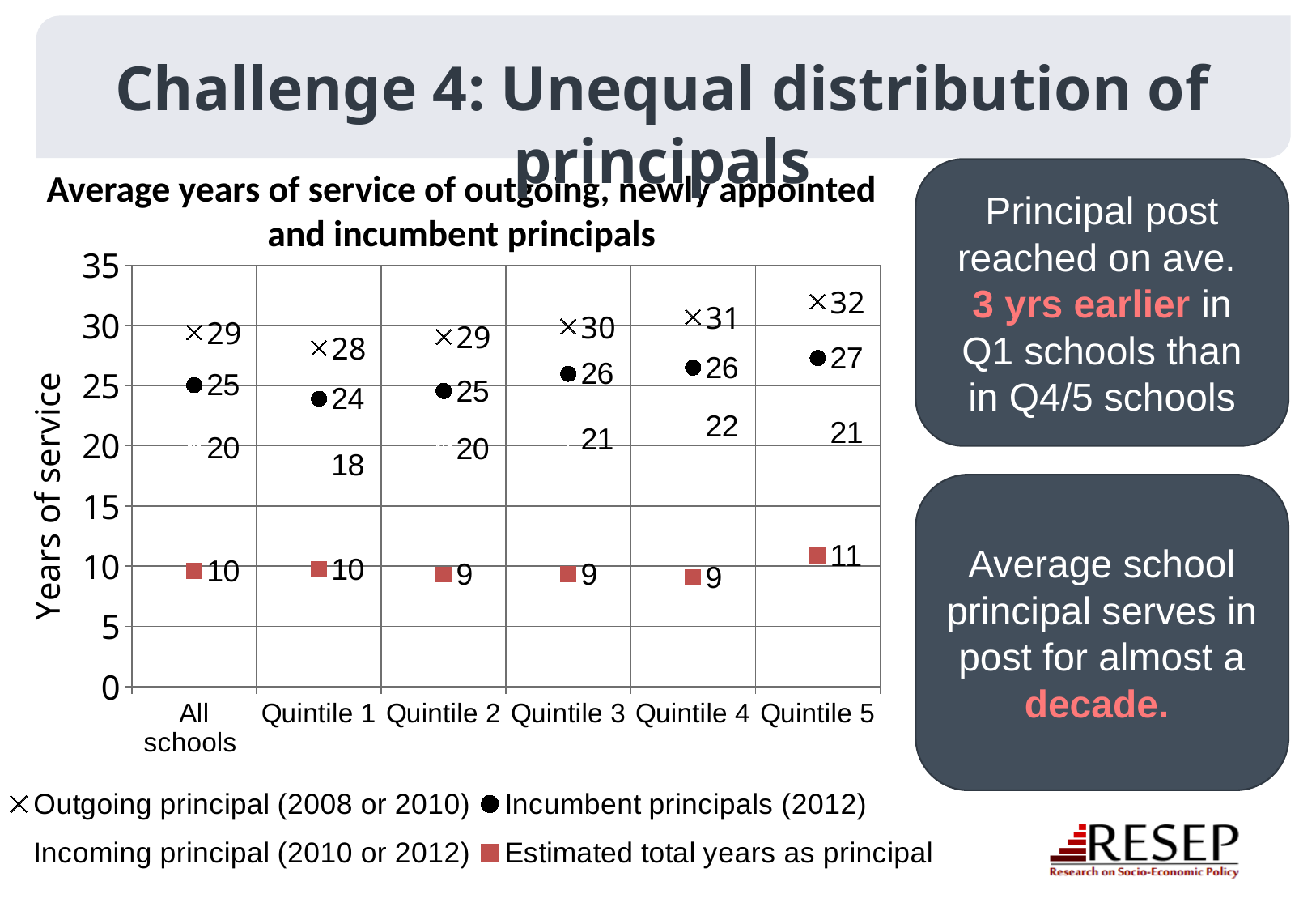
How many series does the legend list? 4 Which category has the highest value for Outgoing principal (2008 or 2010)? Quintile 5 Do the Outgoing principal (2008 or 2010) values rise or fall from Quintile 1 to Quintile 5? rise What is the value for Incoming principal (2010 or 2012) at Quintile 4? 22 What is the y-axis label of the chart? Years of service Which is larger: the Estimated total years as principal at Quintile 5 or at Quintile 4? Quintile 5 What is the value for Incumbent principals (2012) at Quintile 1? 24 What is the value for Outgoing principal (2008 or 2010) at Quintile 5? 32 What is the difference between the Outgoing principal value and the Incumbent principals value at Quintile 3? 4 How many categories are shown on the x axis? 6 What is the Estimated total years as principal for All schools? 10 Which category has the lowest value for Incoming principal (2010 or 2012)? Quintile 1